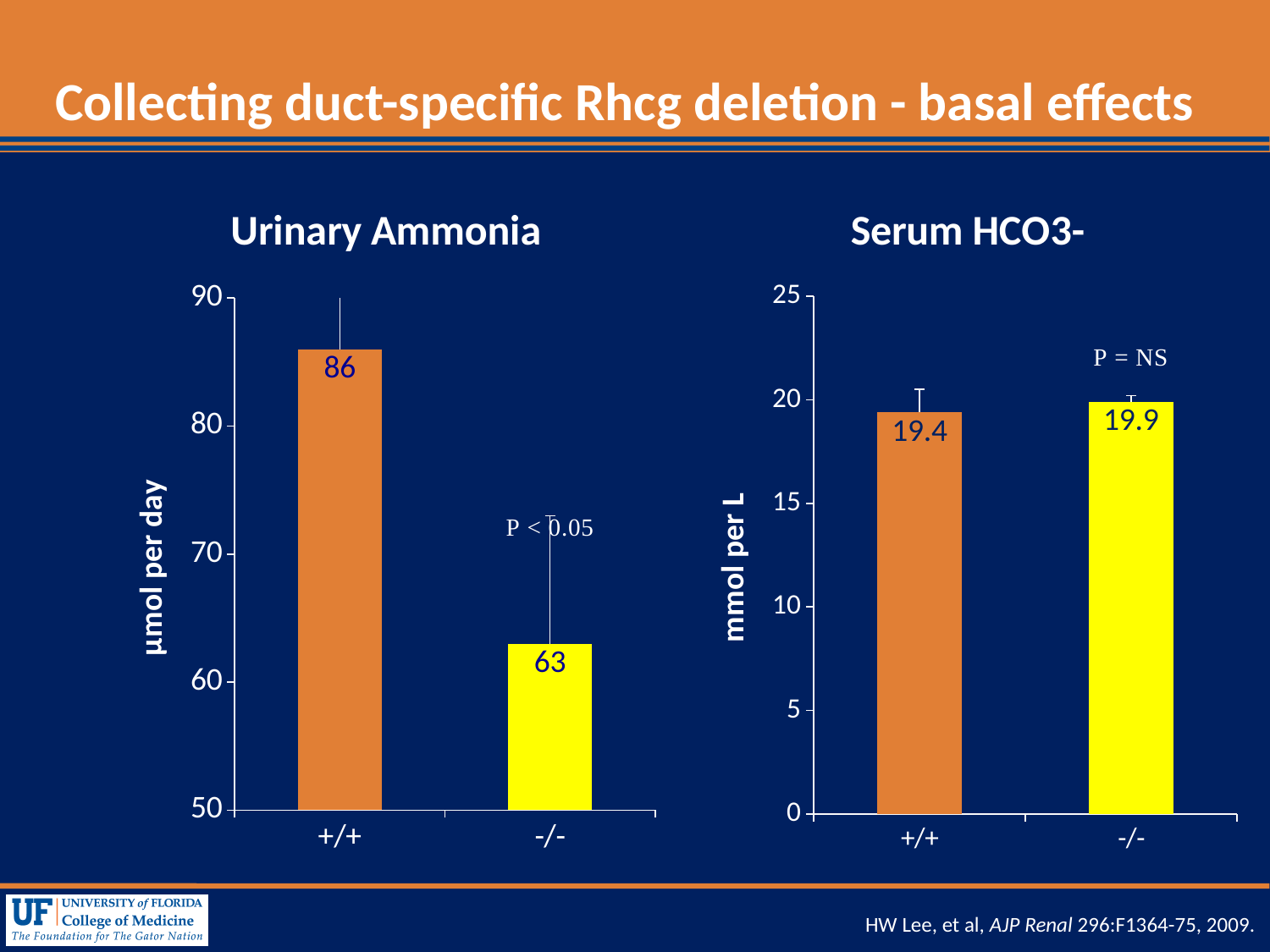
What is the y-axis label of the Serum HCO3- chart? mmol per L In the Urinary Ammonia chart, what is the value for -/-? 63 In the Urinary Ammonia chart, is the value for -/- greater or less than 70? less In the Urinary Ammonia chart, which category has the higher value? +/+ In the Urinary Ammonia chart, what is the difference between the +/+ and -/- values? 23 In the Serum HCO3- chart, what is the difference between the -/- and +/+ values? 0.5 How many categories are shown in the Serum HCO3- chart? 2 In the Urinary Ammonia chart, what is the value for +/+? 86 In the Serum HCO3- chart, is the value for +/+ greater or less than 15? greater What kind of chart is the Urinary Ammonia chart? bar chart In the Serum HCO3- chart, what is the value for -/-? 19.9 In the Serum HCO3- chart, what is the value for +/+? 19.4